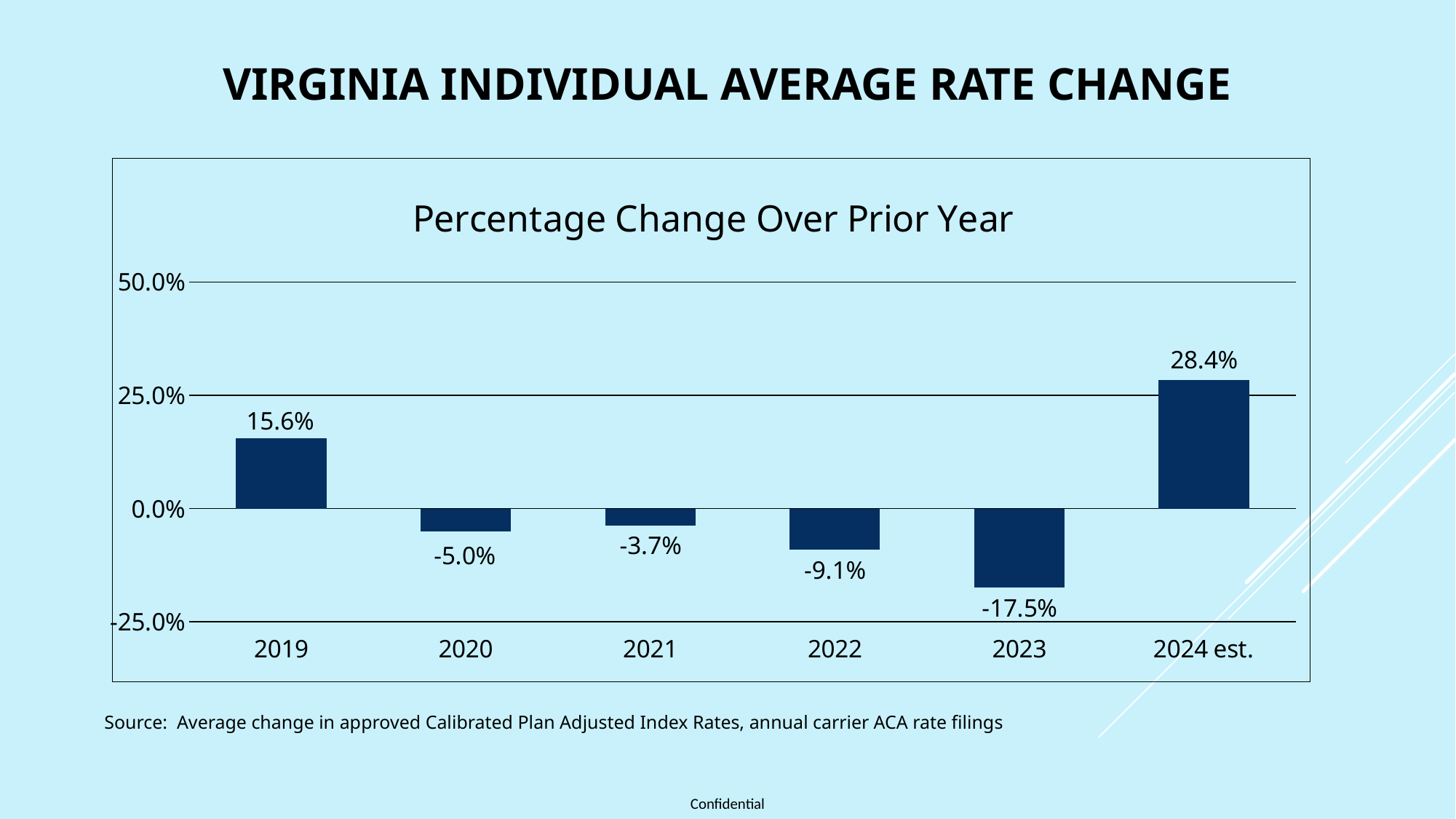
Which year has the lowest percentage change? 2023 What is the estimated percentage change for 2024? 28.4% Is the value for 2024 est. greater or less than 25.0%? greater What is the percentage change for 2019? 15.6% What kind of chart is shown on the slide? Bar chart What is the difference between the 2024 est. value and the 2019 value? 12.8 percentage points Which year has the highest percentage change? 2024 est. How many years are shown on the chart? 6 What is the percentage change for 2023? -17.5% Which year has a larger percentage change, 2020 or 2022? 2020 What is the percentage change for 2021? -3.7% What is the title of the chart? Percentage Change Over Prior Year